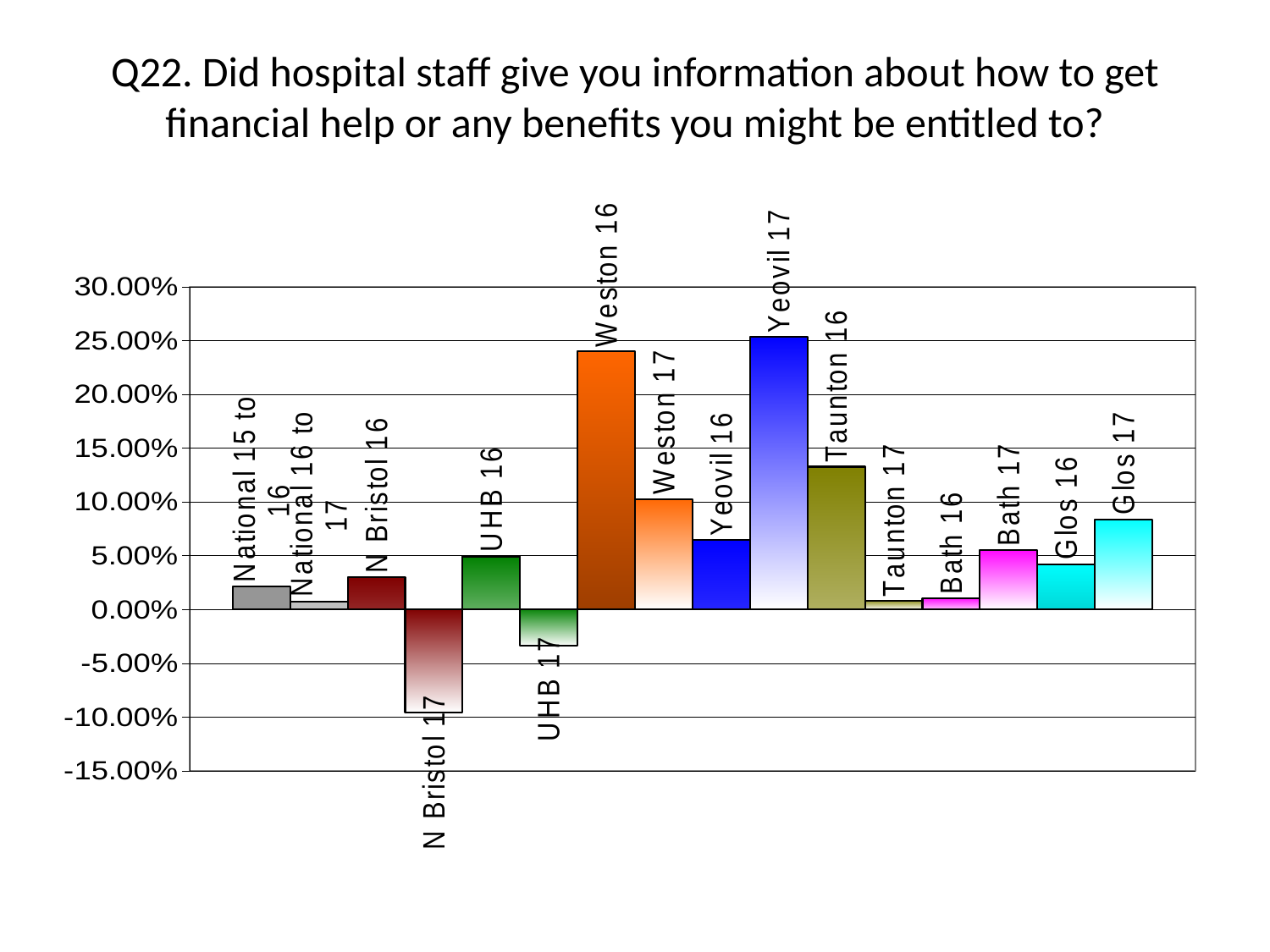
Is the value for N Bristol 17 greater or less than -5.00%? less Is the value for Weston 16 greater or less than 20.00%? greater Which category has the lowest value in the chart? N Bristol 17 Is the value for Taunton 16 greater or less than 10.00%? greater Which is larger, the value for Taunton 16 or Taunton 17? Taunton 16 Which is larger, the value for Weston 16 or Weston 17? Weston 16 Which category has the highest value in the chart? Yeovil 17 What question number is shown in the slide title? Q22 What kind of chart is shown on the slide? bar chart How many bars (categories) are plotted in the chart? 16